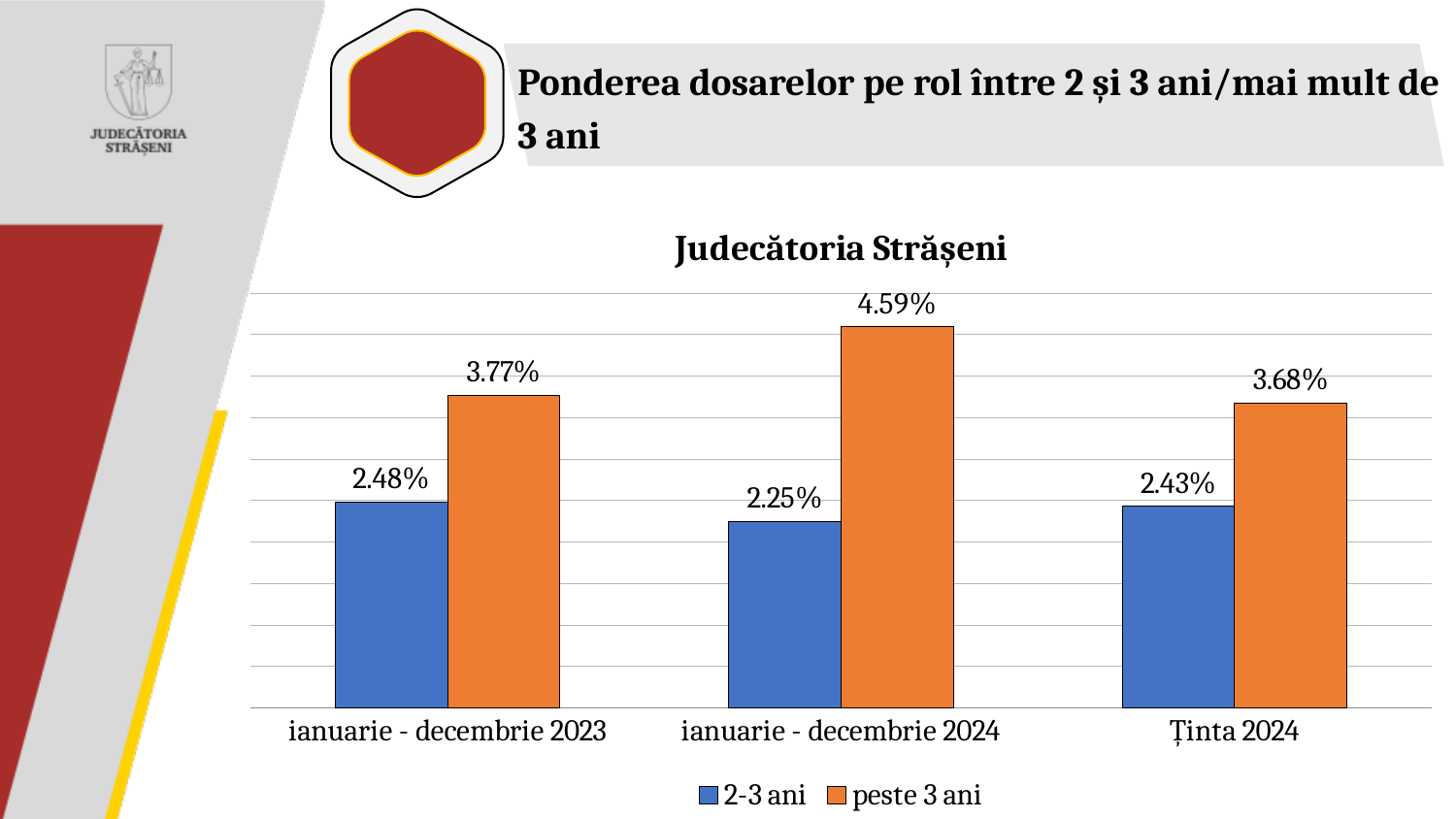
What is the value for "2-3 ani" in ianuarie - decembrie 2023? 2.48% What is the value for "peste 3 ani" for Ținta 2024? 3.68% Which is larger: "2-3 ani" in ianuarie - decembrie 2023 or "2-3 ani" for Ținta 2024? ianuarie - decembrie 2023 What type of chart is shown on the slide? Bar chart What is the value for "peste 3 ani" in ianuarie - decembrie 2024? 4.59% Which category has the highest value for "peste 3 ani"? ianuarie - decembrie 2024 What is the value for "2-3 ani" for Ținta 2024? 2.43% Which category has the lowest value for "2-3 ani"? ianuarie - decembrie 2024 What is the difference between the "peste 3 ani" values for ianuarie - decembrie 2024 and ianuarie - decembrie 2023? 0.82% How many categories are shown on the x axis? 3 How many series does the legend list? 2 What is the difference between "peste 3 ani" and "2-3 ani" in ianuarie - decembrie 2024? 2.34%